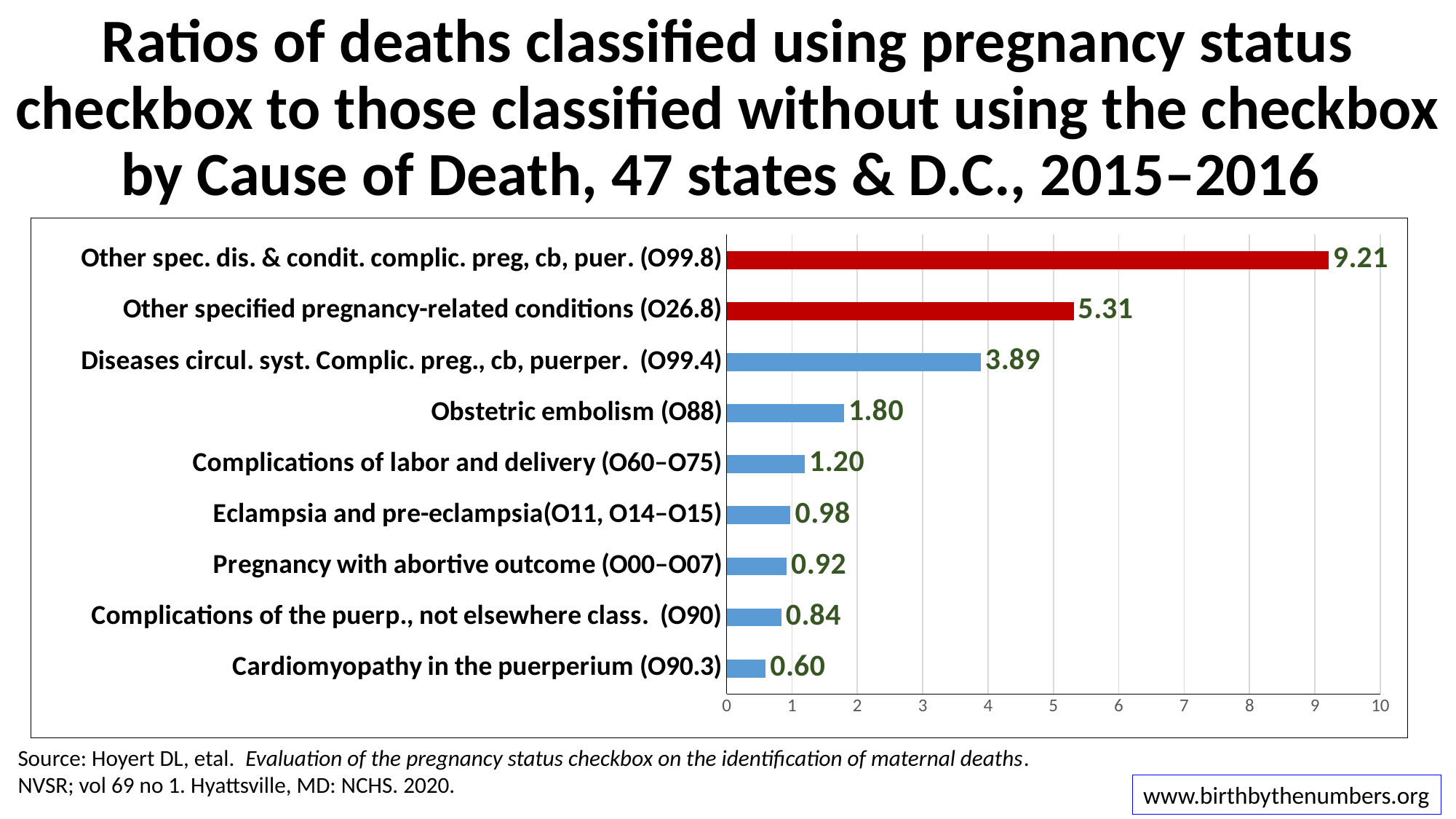
Which cause of death has the highest ratio? Other spec. dis. & condit. complic. preg, cb, puer. (O99.8) What is the ratio for Other specified pregnancy-related conditions (O26.8)? 5.31 How many bars are coloured red? 2 What is the ratio for Obstetric embolism (O88)? 1.80 Which has a larger ratio: Eclampsia and pre-eclampsia (O11, O14–O15) or Pregnancy with abortive outcome (O00–O07)? Eclampsia and pre-eclampsia (O11, O14–O15) Is the ratio for Diseases circul. syst. Complic. preg., cb, puerper. (O99.4) greater or less than 3? greater What is the ratio for Cardiomyopathy in the puerperium (O90.3)? 0.60 Which cause of death has the lowest ratio? Cardiomyopathy in the puerperium (O90.3) What is the difference between the ratios for O99.8 and O26.8? 3.90 How many causes of death are shown in the chart? 9 What is the difference between the ratios for Obstetric embolism (O88) and Complications of labor and delivery (O60–O75)? 0.60 What type of chart is shown on the slide? Bar chart